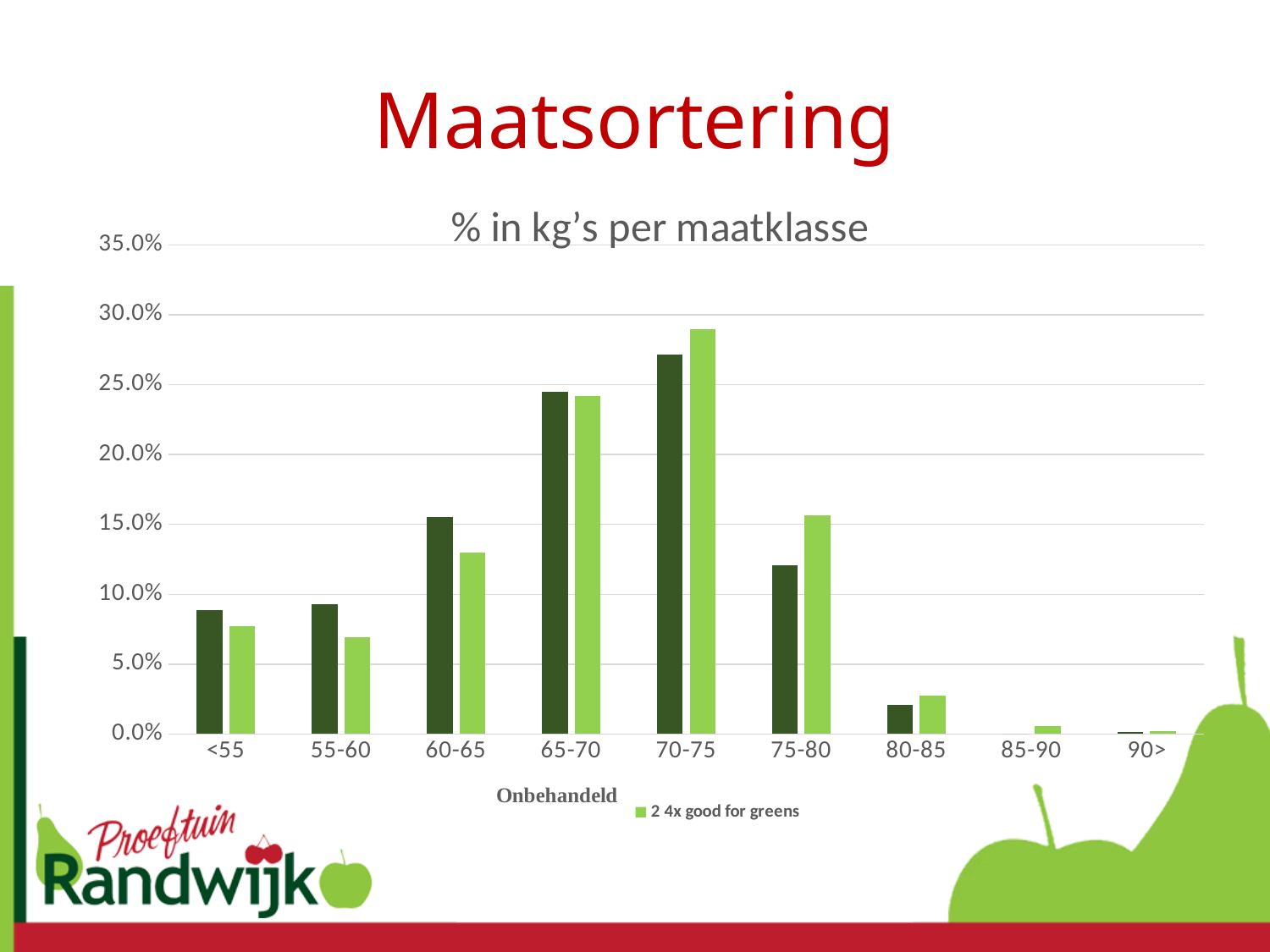
Is the Onbehandeld value for 65-70 greater or less than 20.0%? greater For the 2 4x good for greens series, which size class has the highest value? 70-75 Is the 2 4x good for greens value for 60-65 greater or less than 15.0%? less What kind of chart is shown on the slide? bar chart How many series does the legend list? 2 What is the title of the chart? % in kg's per maatklasse In the 70-75 size class, which series has the larger value? 2 4x good for greens For the Onbehandeld series, which size class has the highest value? 70-75 In the 60-65 size class, which series has the larger value? Onbehandeld Is the Onbehandeld value for 70-75 greater or less than 25.0%? greater In the 75-80 size class, which series has the larger value? 2 4x good for greens How many size classes (categories) are shown on the x axis? 9